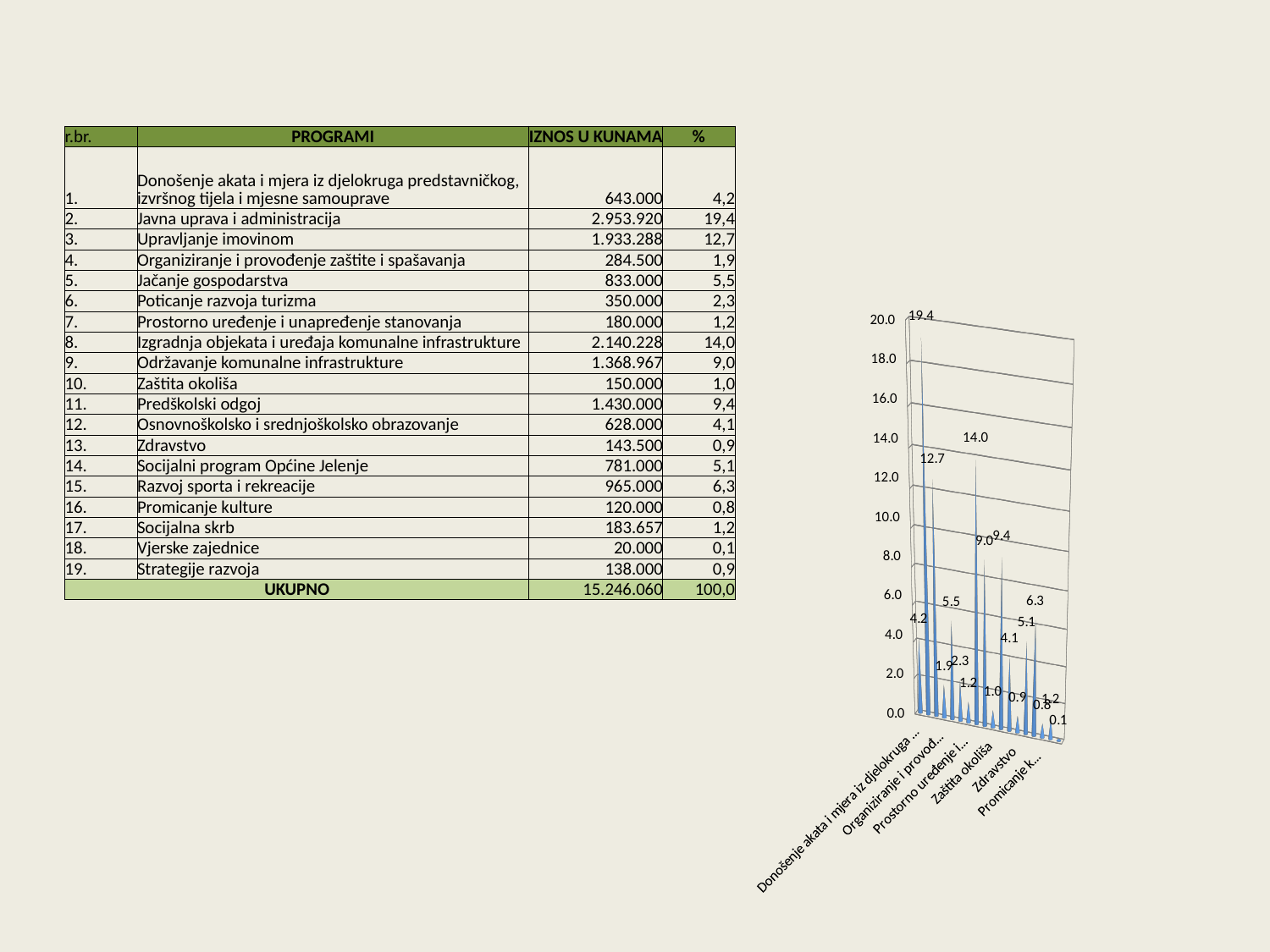
Is the value for the first category (Donošenje akata i mjera...) greater or less than 18.0? less Is the value for Zdravstvo on the chart greater or less than 2.0? less What is the maximum value shown on the chart's vertical axis? 20.0 What is the highest value labelled on the chart? 19.4 What value does the chart show for Zdravstvo? 0.9 What kind of chart is shown on the slide? bar chart What value does the chart show for Zaštita okoliša? 1.0 What is the total percentage shown in the UKUPNO row of the table? 100,0 What is the difference between the highest labelled value (19.4) and the second highest (14.0) on the chart? 5.4 What is the lowest value labelled on the chart? 0.1 How many categories (programs) are plotted in the chart? 18 Which is larger on the chart, the value labelled 12.7 or the value labelled 14.0? 14.0